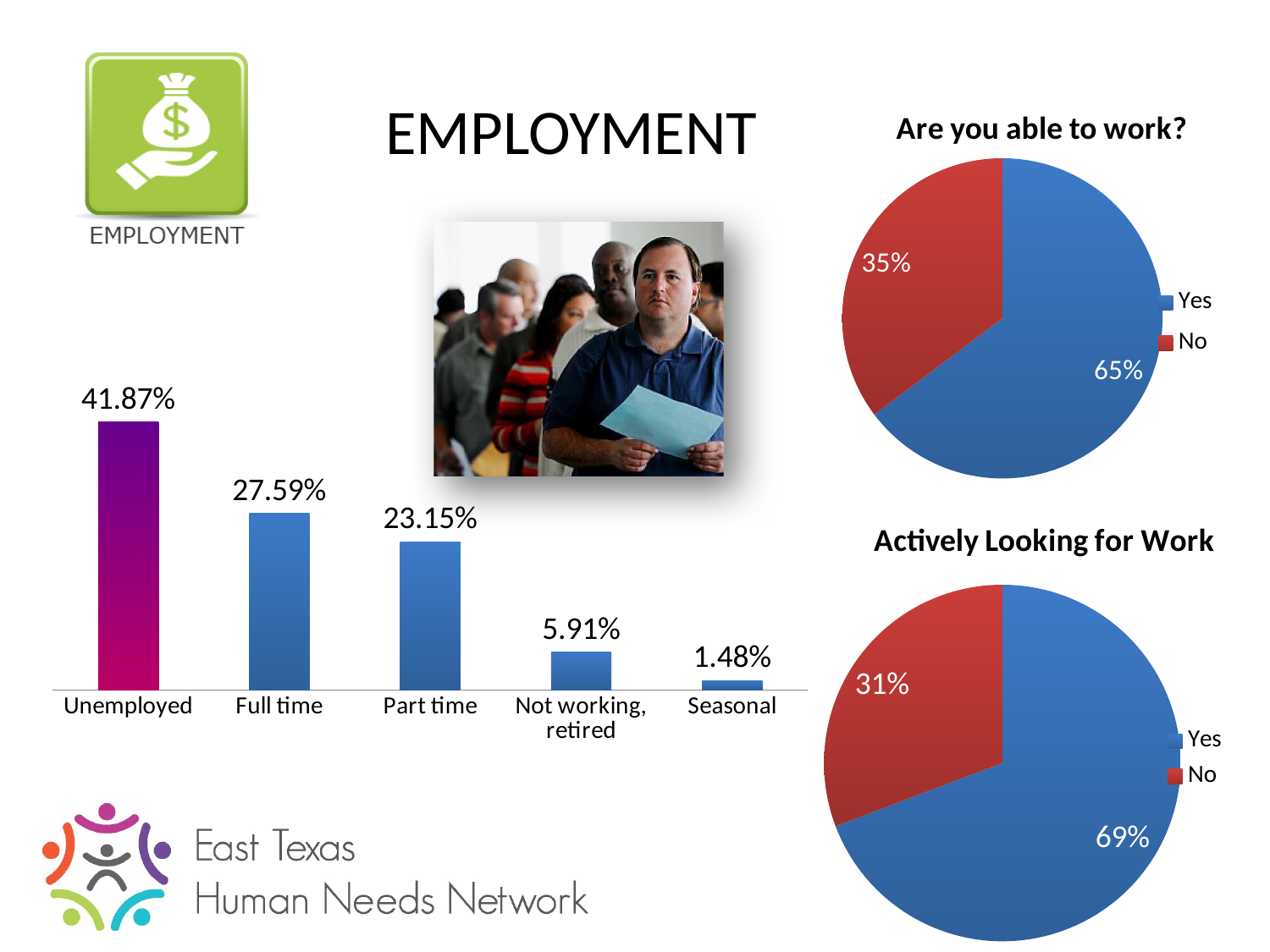
In the bar chart on the left, which is larger: Not working, retired or Seasonal? Not working, retired In the bar chart on the left, which category has the lowest value? Seasonal In the 'Are you able to work?' pie chart, what share answered Yes? 65% In the bar chart on the left, which category has the highest value? Unemployed What kind of chart is the chart on the left? bar chart In the 'Are you able to work?' pie chart, what share answered No? 35% In the bar chart on the left, what is the value for Part time? 23.15% In the bar chart on the left, how many categories are shown? 5 How many entries does the legend of the 'Actively Looking for Work' pie chart list? 2 In the bar chart on the left, what is the value for Unemployed? 41.87% In the bar chart on the left, what is the difference between Full time and Part time? 4.44% In the 'Actively Looking for Work' pie chart, what share answered No? 31%